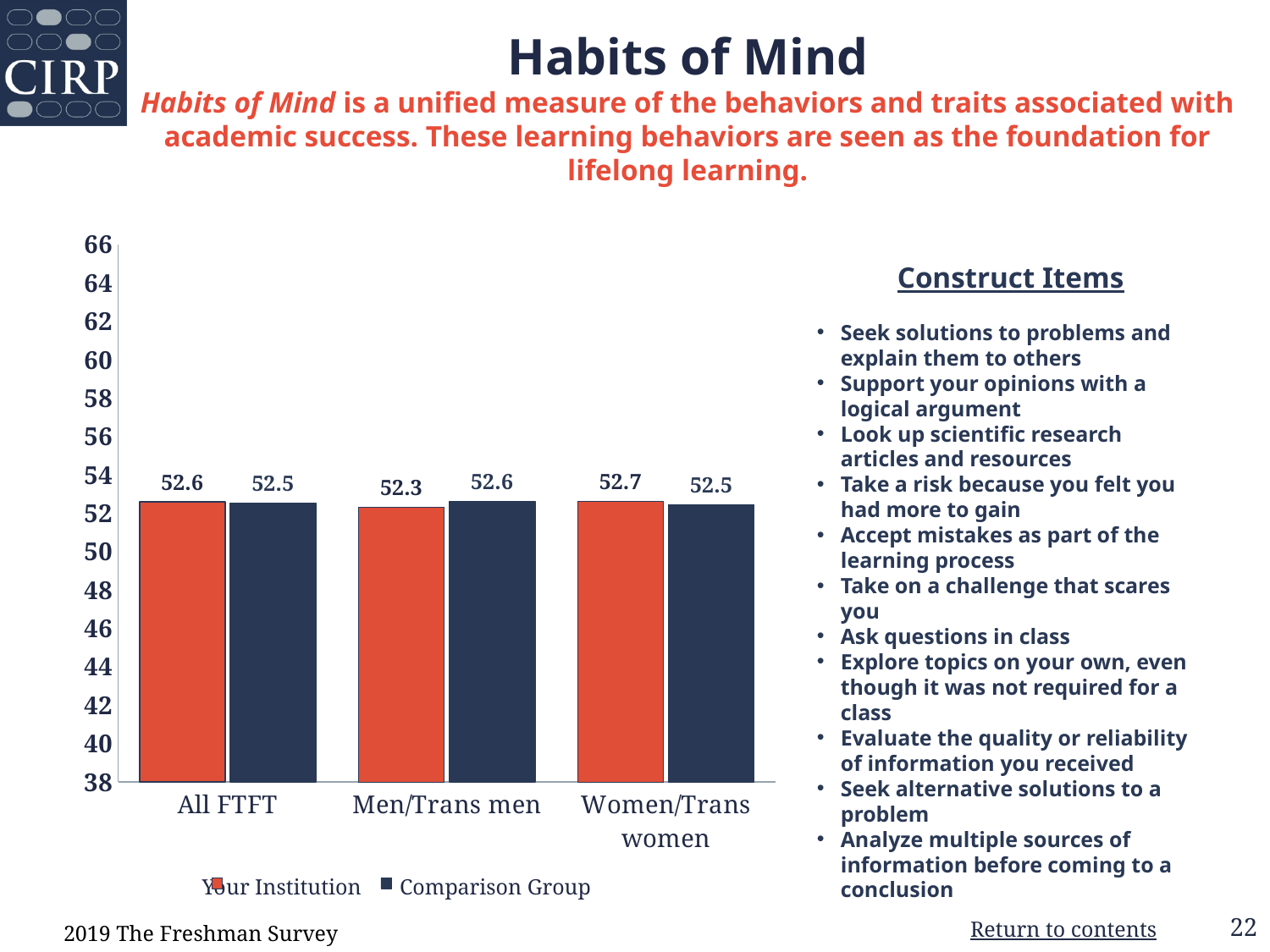
What is the Your Institution value for Women/Trans women? 52.7 How many categories are shown on the x axis? 3 How many series does the legend list? 2 Which category has the lowest Your Institution value? Men/Trans men What is the Comparison Group value for Men/Trans men? 52.6 What is the Your Institution value for All FTFT? 52.6 What colour are the Comparison Group bars? Dark navy blue What is the Comparison Group value for Women/Trans women? 52.5 What kind of chart is shown on the slide? Bar chart What is the difference between the Comparison Group and Your Institution values for Men/Trans men? 0.3 For Men/Trans men, which is larger: Your Institution or Comparison Group? Comparison Group Which category has the highest Your Institution value? Women/Trans women